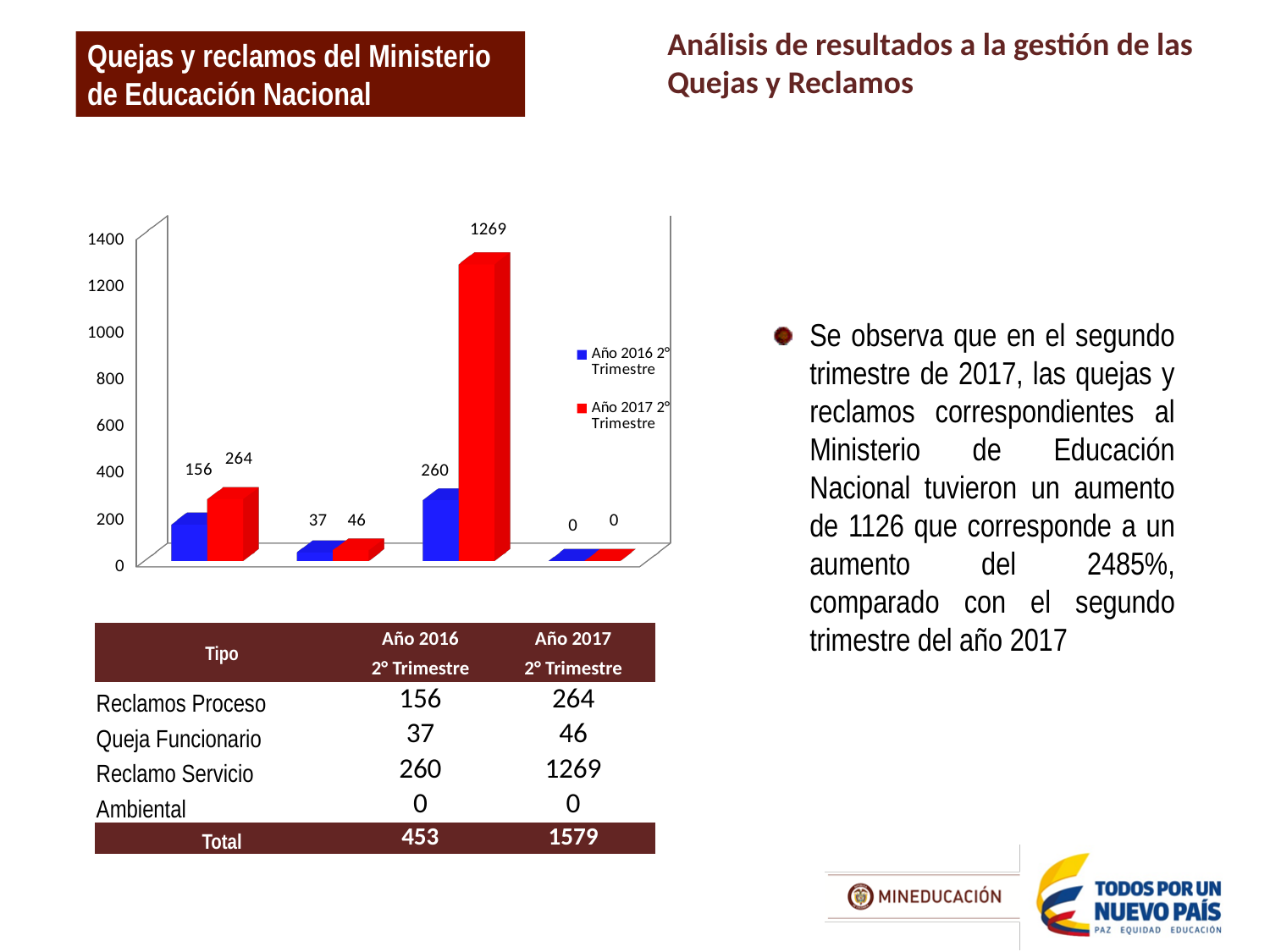
What is the difference between the Año 2017 2° Trimestre and Año 2016 2° Trimestre values for Queja Funcionario? 9 Which is larger in the Año 2017 2° Trimestre series: Reclamos Proceso or Queja Funcionario? Reclamos Proceso What kind of chart is shown on the slide? bar chart What is the difference between the Año 2017 2° Trimestre and Año 2016 2° Trimestre values for Reclamo Servicio? 1009 What is the value for Reclamo Servicio in the Año 2017 2° Trimestre series? 1269 What is the value for Reclamos Proceso in the Año 2016 2° Trimestre series? 156 How many series does the chart legend list? 2 Is the value for Reclamo Servicio in the Año 2017 2° Trimestre series greater or less than 1000? greater How many categories are plotted in the chart? 4 What is the value for Queja Funcionario in the Año 2017 2° Trimestre series? 46 Which category has the lowest value in the Año 2016 2° Trimestre series? Ambiental Which category has the highest value in the Año 2017 2° Trimestre series? Reclamo Servicio